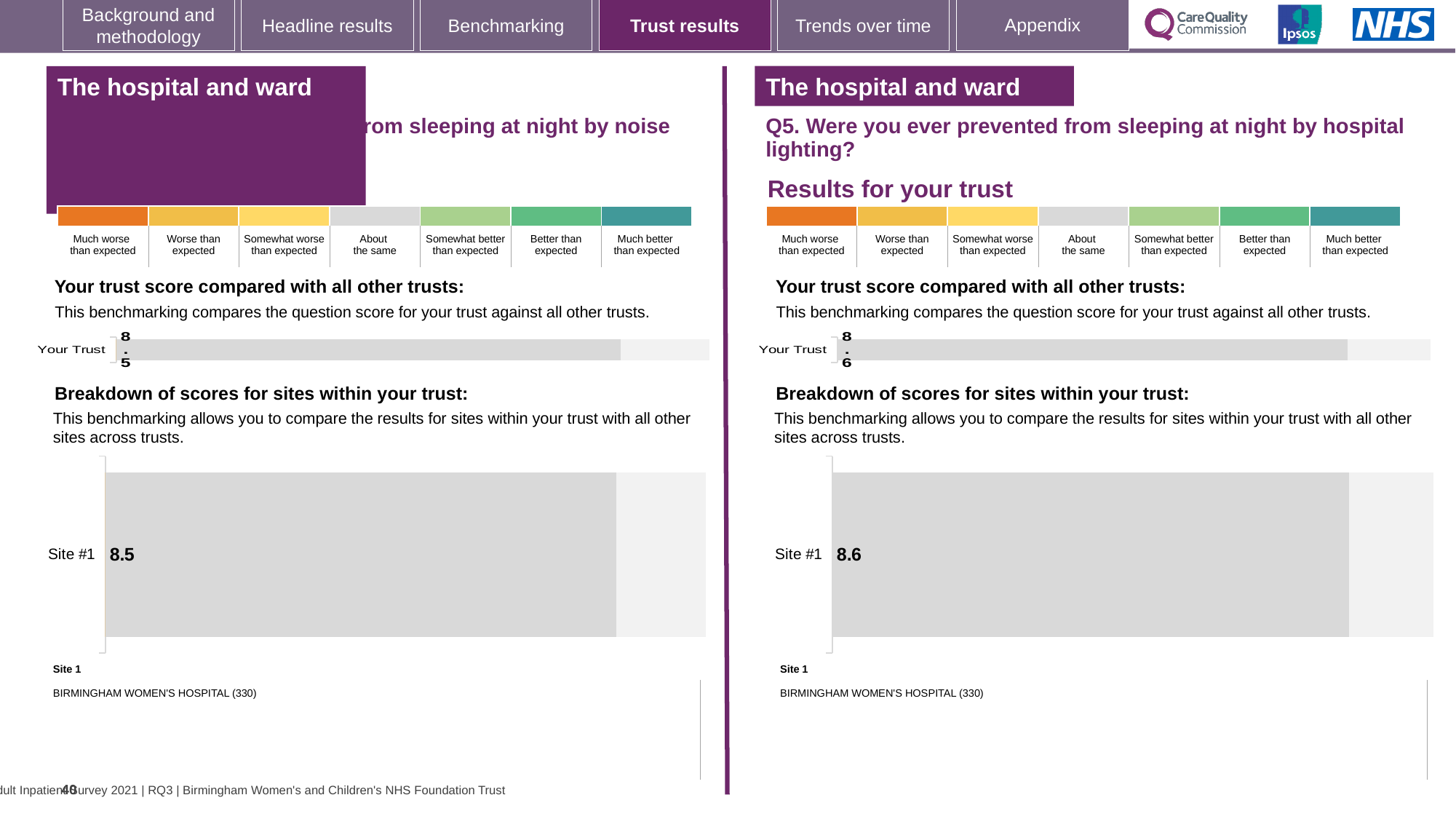
On the left half of the slide (sleeping at night by noise), what is the score shown for Your Trust? 8.5 In the right 'Breakdown of scores for sites within your trust' chart (Q5), what is the value for Site #1? 8.6 Which hospital is listed as Site 1 below the right 'Breakdown of scores' chart (Q5)? BIRMINGHAM WOMEN'S HOSPITAL (330) How many sites are plotted in the left 'Breakdown of scores for sites within your trust' chart? 1 How many rating categories are shown in the colour scale above the right chart (Q5), from 'Much worse than expected' to 'Much better than expected'? 7 What kind of chart is used for the 'Breakdown of scores for sites within your trust' on the right half of the slide? Bar chart What is the difference between the Site #1 score in the right chart (Q5) and the Site #1 score in the left chart (noise)? 0.1 How many sites are plotted in the right 'Breakdown of scores for sites within your trust' chart (Q5)? 1 On the right half of the slide (Q5, hospital lighting), what is the score shown for Your Trust? 8.6 Which is larger: the Site #1 score in the left chart (noise) or the Site #1 score in the right chart (Q5, hospital lighting)? Right chart (Q5, hospital lighting) In the left 'Breakdown of scores for sites within your trust' chart, what is the value for Site #1? 8.5